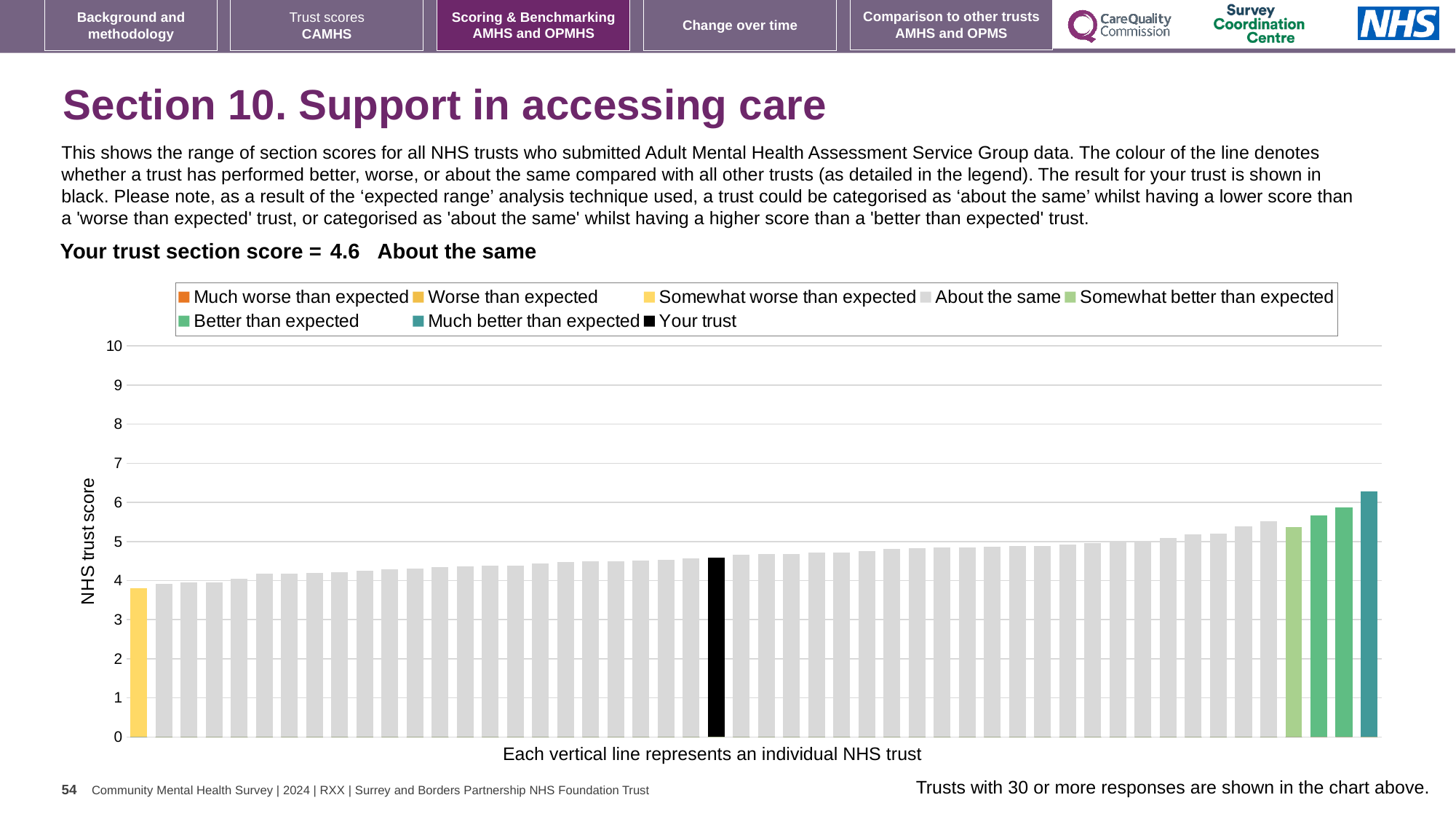
Do the bar values rise or fall from left to right along the x axis? rise How many trusts are shown as 'Better than expected' (green bars)? 2 How is your trust's section score categorised compared with other trusts? About the same How many trusts are shown as 'Much better than expected' (teal bars)? 1 How many entries does the legend list? 8 What is the label on the y axis of the chart? NHS trust score What is the section score for your trust? 4.6 Is the value for your trust (the black bar) greater or less than 5? less Is the value of the tallest bar greater or less than 6? greater Which is larger: the score for your trust or the score of the leftmost bar? your trust Is the value of the leftmost (yellow) bar greater or less than 4? less What kind of chart is shown on the slide? bar chart